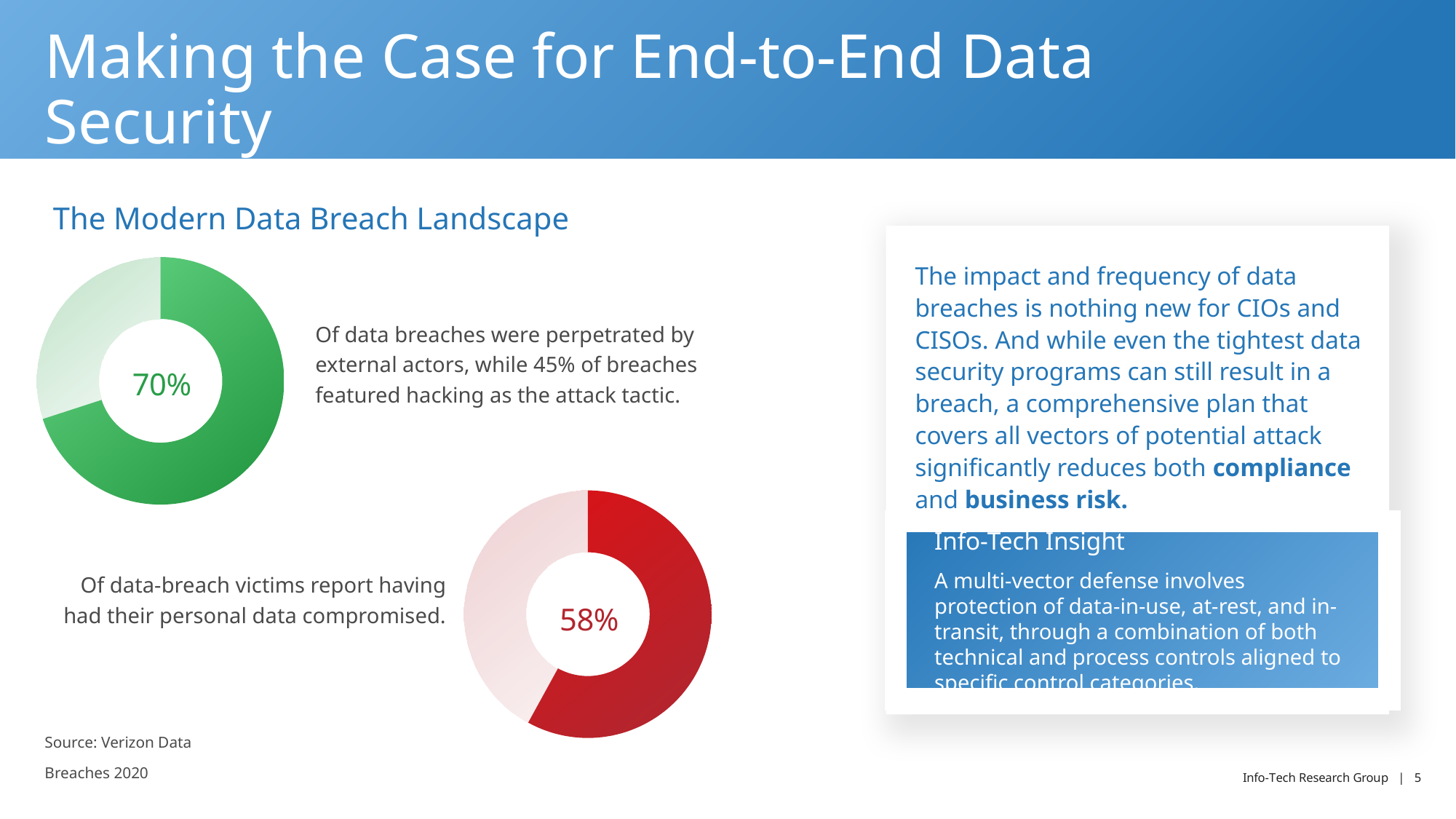
How many slices does the red donut chart at the bottom have? 2 What kind of chart is the green chart on the left of the slide? Donut (pie) chart In the green donut chart, what share of the whole does the highlighted (dark green) slice represent? 70% What is the difference between the value in the green donut chart and the value in the red donut chart? 12 percentage points How many donut charts are shown on the slide? 2 What kind of chart is the red chart at the bottom of the slide? Donut (pie) chart What colour is the highlighted slice of the donut chart showing 58%? Red Which chart shows the larger highlighted share, the green donut chart or the red donut chart? The green donut chart What value is shown in the centre of the red donut chart at the bottom? 58% How many slices does the green donut chart on the left have? 2 What value is shown in the centre of the green donut chart on the left? 70% In the red donut chart, what share of the whole does the highlighted (dark red) slice represent? 58%